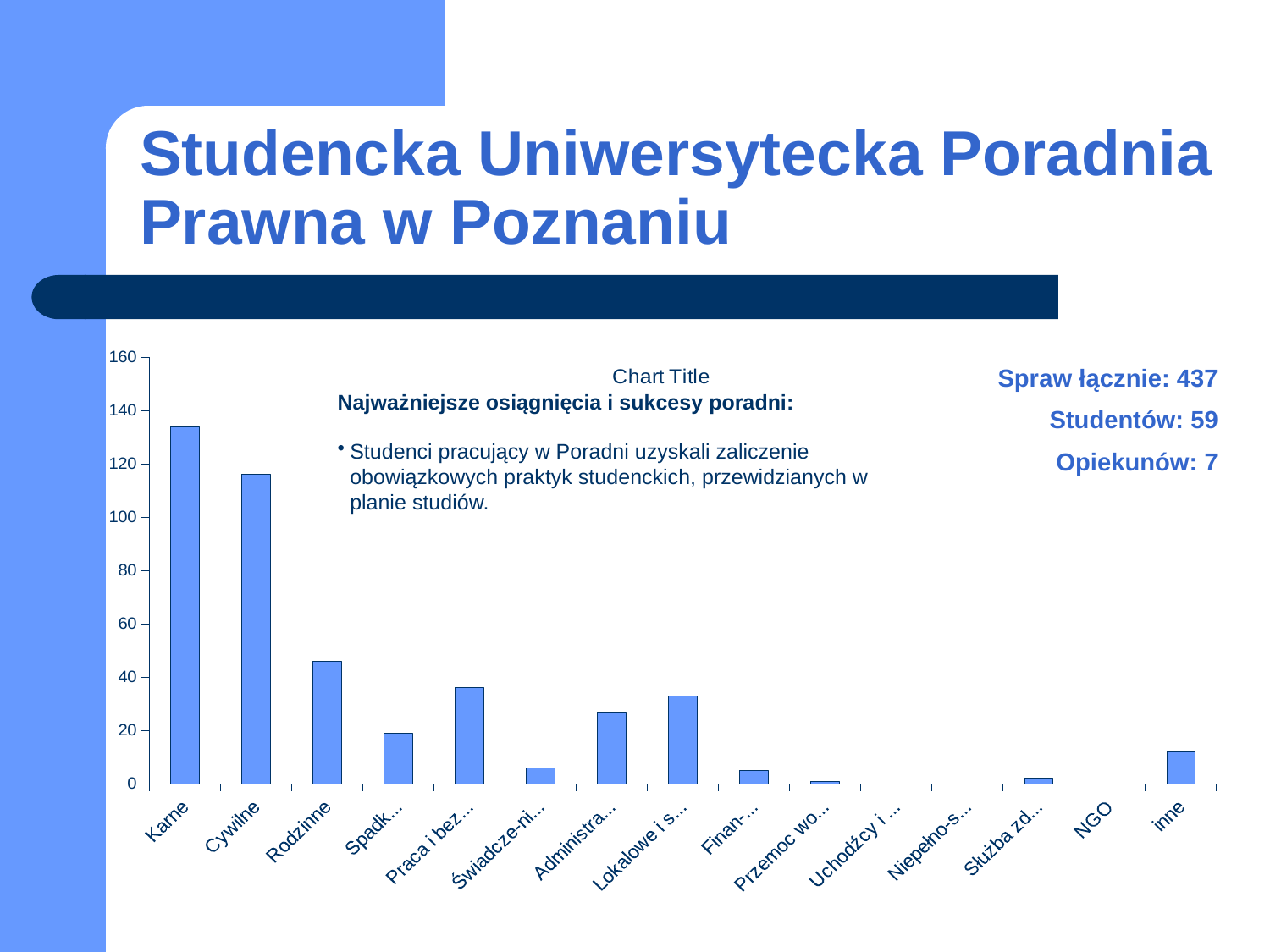
How many categories are plotted along the x axis of the chart? 15 Which is larger, the value for Karne or the value for Cywilne? Karne What title text is displayed at the top of the chart? Chart Title Which is larger, the value for Rodzinne or the value for inne? Rodzinne What is the highest tick value shown on the vertical axis of the chart? 160 Is the value for Karne greater or less than 120? greater Which category has the highest bar in the chart? Karne Is the value for Rodzinne greater or less than 60? less Is the value for inne greater or less than 20? less What kind of chart is shown on the slide? bar chart